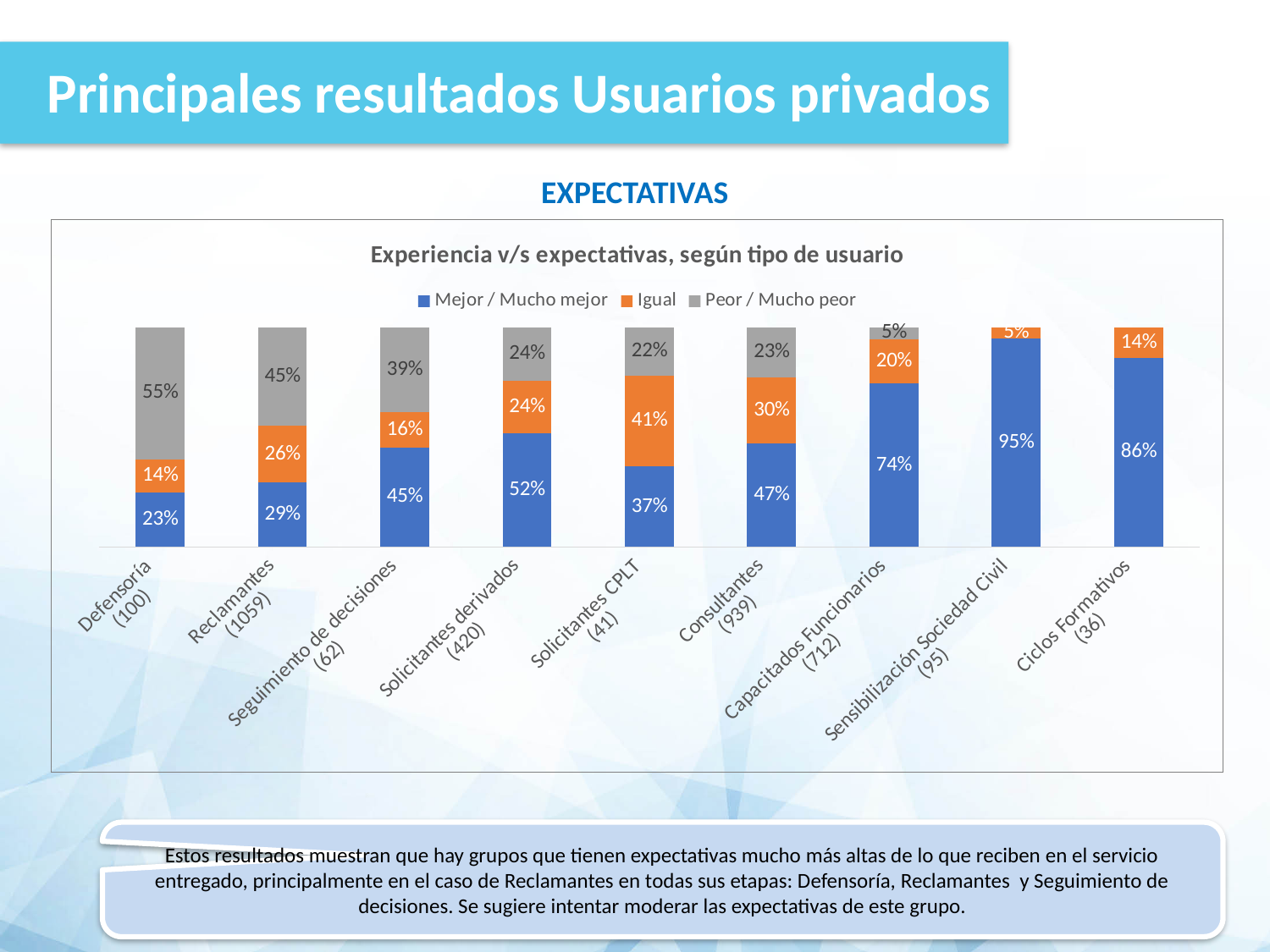
What is the difference between the 'Mejor / Mucho mejor' values for Capacitados Funcionarios (712) and Consultantes (939)? 27% Which is larger: the 'Peor / Mucho peor' value for Defensoría (100) or for Seguimiento de decisiones (62)? Defensoría (100) What is the 'Igual' value for Solicitantes CPLT (41)? 41% Which category has the lowest 'Mejor / Mucho mejor' value? Defensoría (100) How many user-type categories are shown on the x axis? 9 What is the 'Mejor / Mucho mejor' value for Defensoría (100)? 23% What is the 'Peor / Mucho peor' value for Reclamantes (1059)? 45% What is the title of the chart? Experiencia v/s expectativas, según tipo de usuario How many series does the chart legend list? 3 What type of chart is shown on the slide? Stacked bar chart Which colour represents the 'Igual' series in the chart? Orange Which category has the highest 'Mejor / Mucho mejor' value? Sensibilización Sociedad Civil (95)